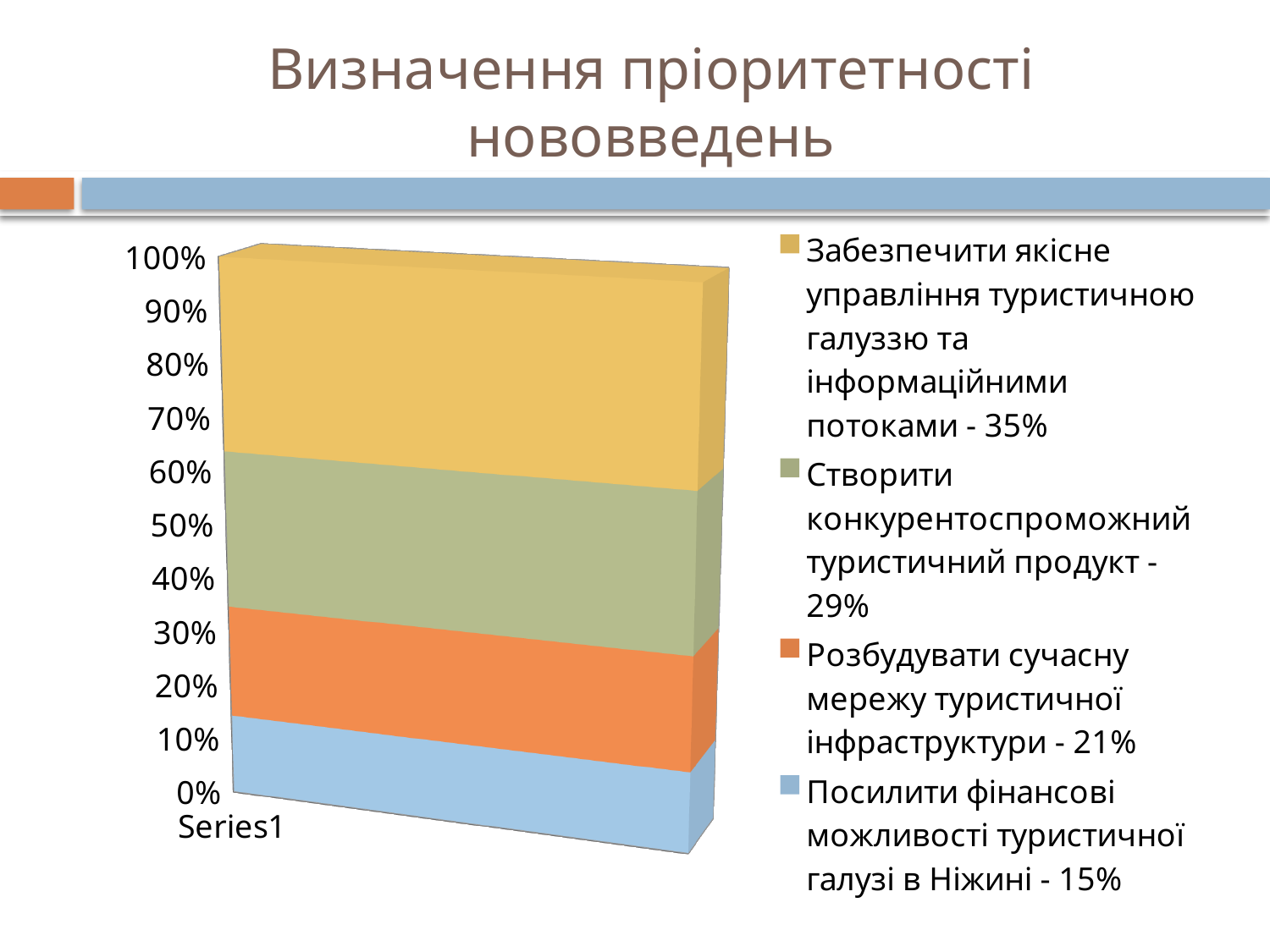
What is the value for "Забезпечити якісне управління туристичною галуззю та інформаційними потоками"? 35% What is the value for "Посилити фінансові можливості туристичної галузі в Ніжині"? 15% What is the value for "Розбудувати сучасну мережу туристичної інфраструктури"? 21% Which legend entry has the lowest value? Посилити фінансові можливості туристичної галузі в Ніжині Which is larger: the value for "Розбудувати сучасну мережу туристичної інфраструктури" or the value for "Посилити фінансові можливості туристичної галузі в Ніжині"? Розбудувати сучасну мережу туристичної інфраструктури What is the total of the stacked bar for Series1? 100% What is the title of the chart slide? Визначення пріоритетності нововведень What kind of chart is shown on the slide? stacked bar chart What is the value for "Створити конкурентоспроможний туристичний продукт"? 29% Which legend entry has the highest value? Забезпечити якісне управління туристичною галуззю та інформаційними потоками What is the difference between the value for "Створити конкурентоспроможний туристичний продукт" and the value for "Посилити фінансові можливості туристичної галузі в Ніжині"? 14% How many series does the legend list? 4